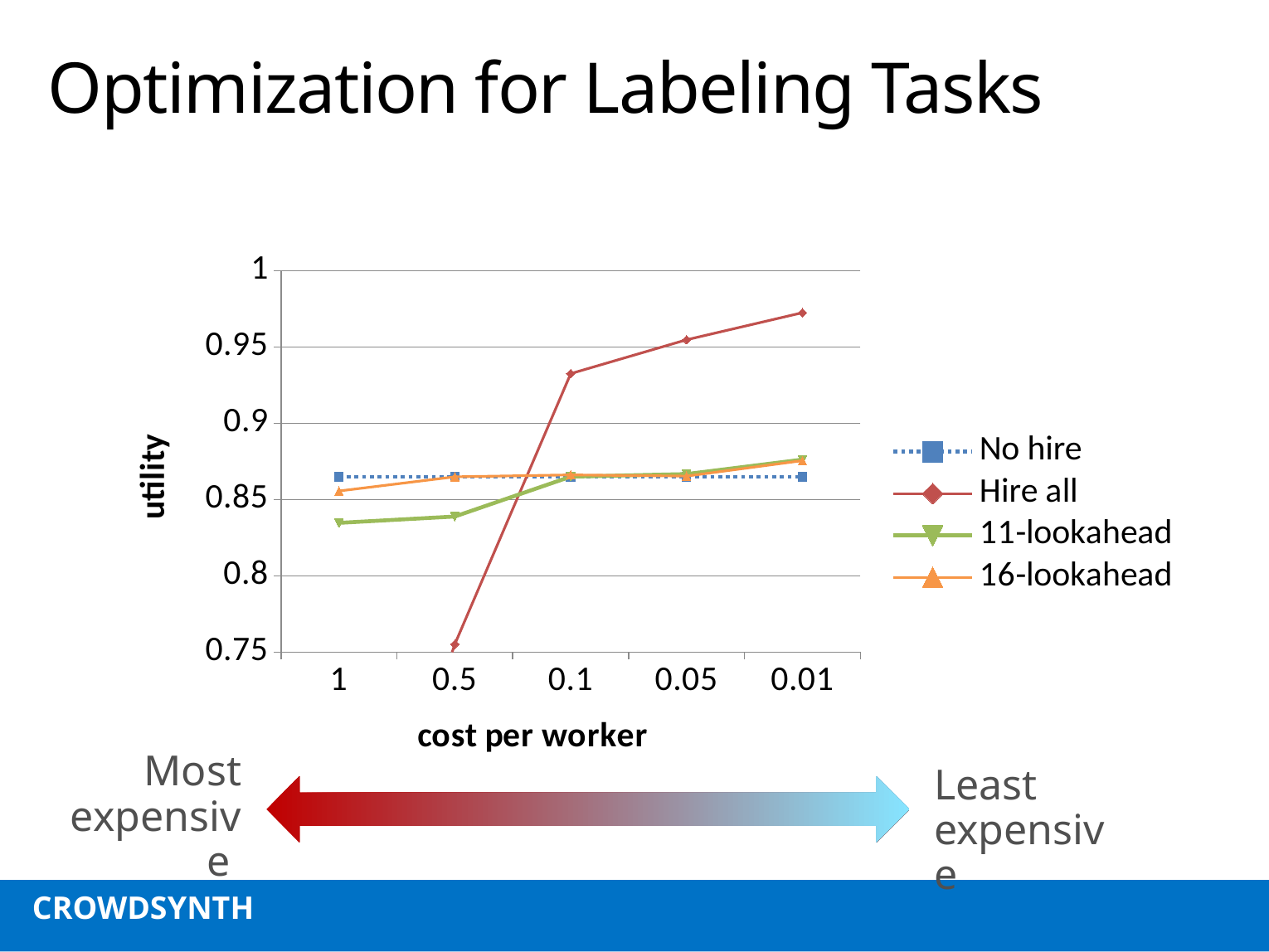
Is the utility for 11-lookahead at a cost per worker of 1 greater or less than 0.85? less Is the utility for Hire all at a cost per worker of 0.1 greater or less than 0.9? greater At a cost per worker of 0.5, which series has the lowest utility? Hire all Is the utility for Hire all at a cost per worker of 0.5 greater or less than 0.8? less How many series does the legend list? 4 At a cost per worker of 0.01, which series has the highest utility? Hire all What kind of chart is shown on the slide? line chart At a cost per worker of 1, which has the higher utility: No hire or 11-lookahead? No hire Does the utility for Hire all rise or fall as cost per worker moves from 0.5 to 0.01 along the x axis? rise How many cost per worker values are shown on the x axis? 5 What is the label on the y axis of the chart? utility